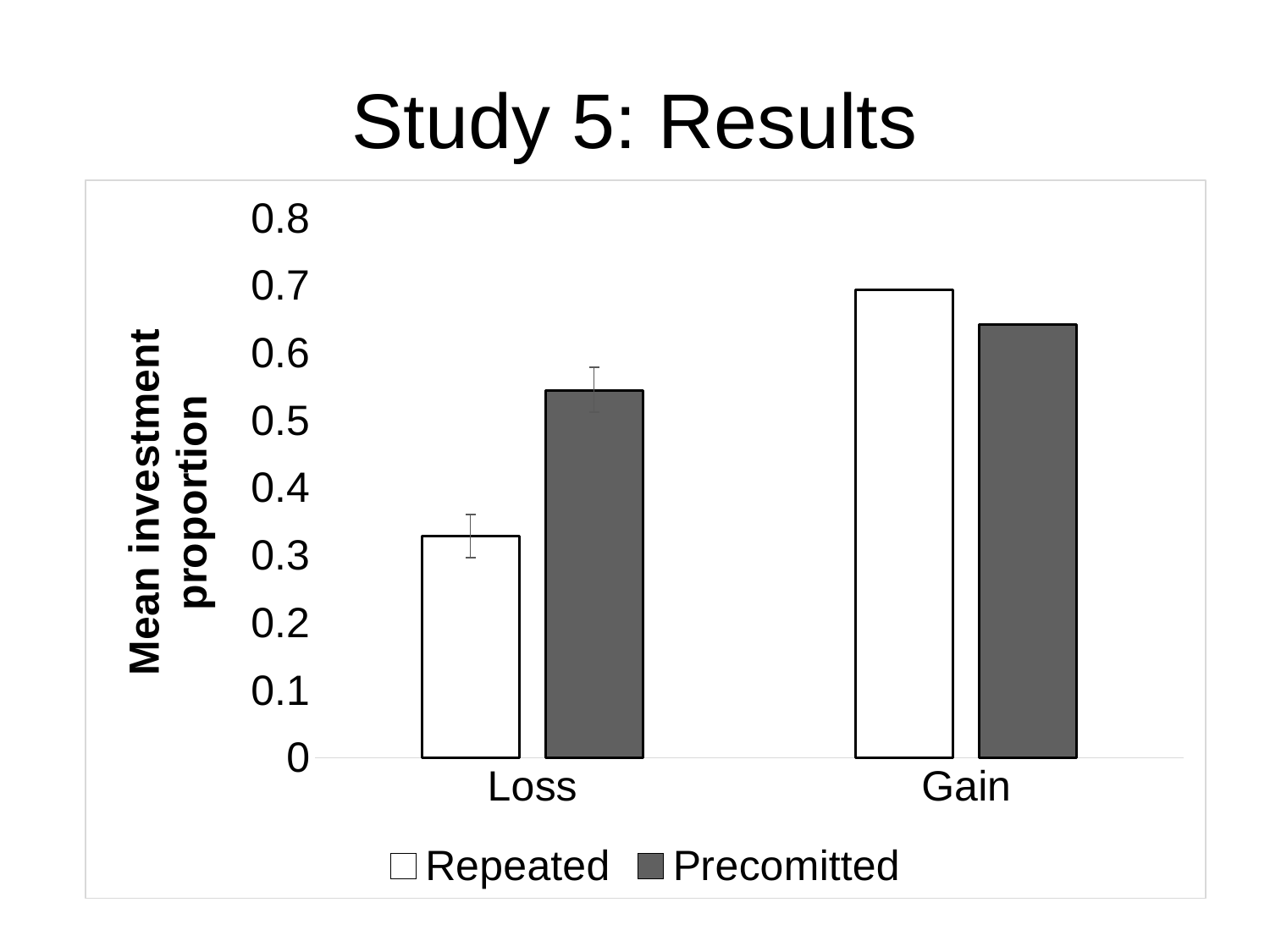
How many categories are shown on the x axis? 2 Which bar is the tallest in the chart? Repeated in Gain Is the Repeated value for Gain greater or less than 0.6? greater Is the Repeated value for Loss greater or less than 0.4? less Which bar is the shortest in the chart? Repeated in Loss What kind of chart is shown on the slide? bar chart In the Loss condition, which series has the larger value, Repeated or Precomitted? Precomitted How many series does the legend list? 2 In the Gain condition, which series has the larger value, Repeated or Precomitted? Repeated Is the Precomitted value for Gain greater or less than 0.7? less What is the label of the y axis? Mean investment proportion